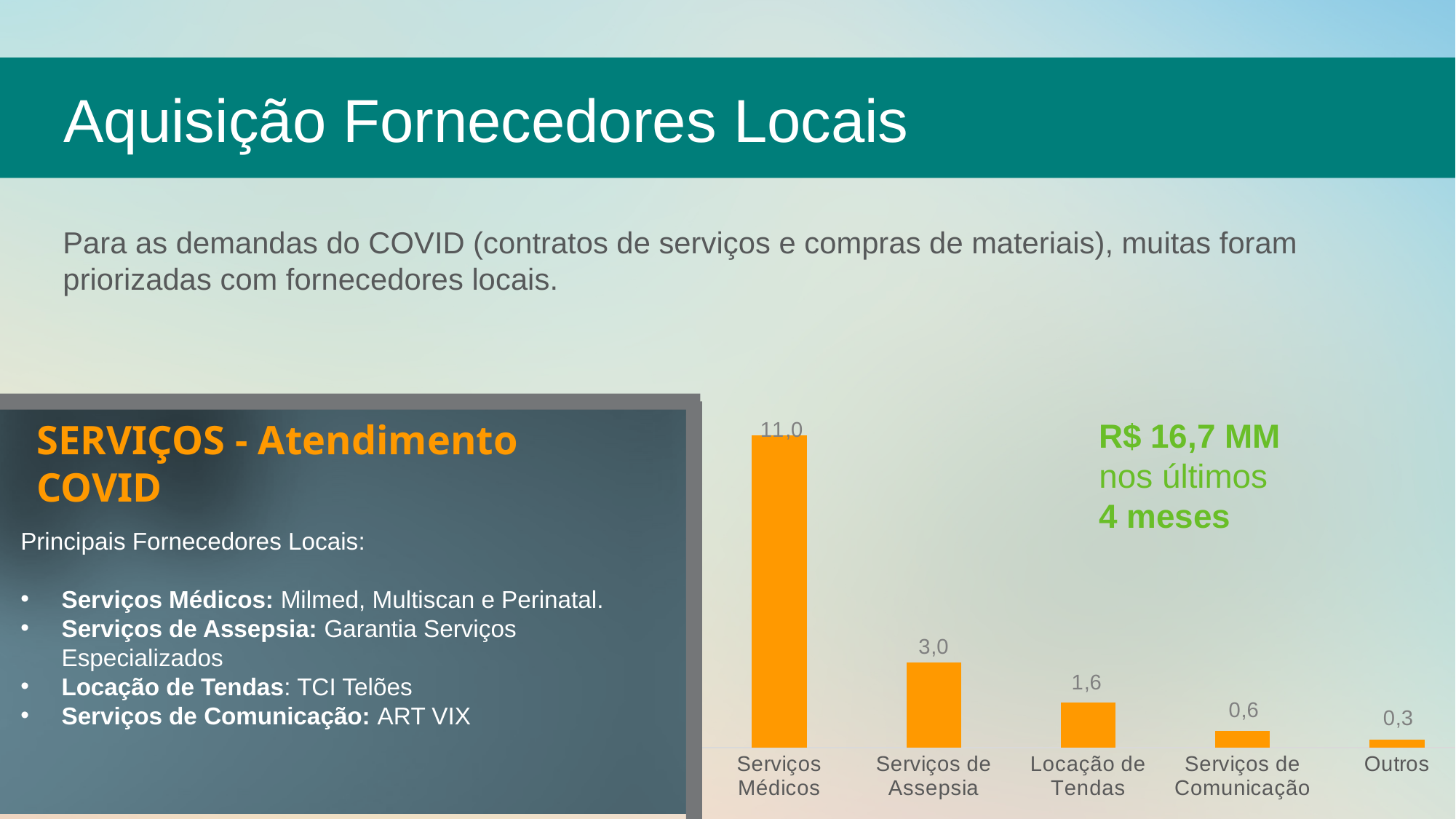
Do the values rise or fall from left to right across the categories? Fall What is the value for Locação de Tendas? 1,6 What kind of chart is shown on the slide? Bar chart What is the value for Serviços Médicos? 11,0 What is the value for Serviços de Comunicação? 0,6 What is the value for Serviços de Assepsia? 3,0 What is the value for Outros? 0,3 How many categories are shown in the chart? 5 Which is larger, the value for Locação de Tendas or the value for Serviços de Comunicação? Locação de Tendas Which category has the lowest value? Outros What is the difference between the values for Serviços Médicos and Serviços de Assepsia? 8,0 Which category has the highest value? Serviços Médicos